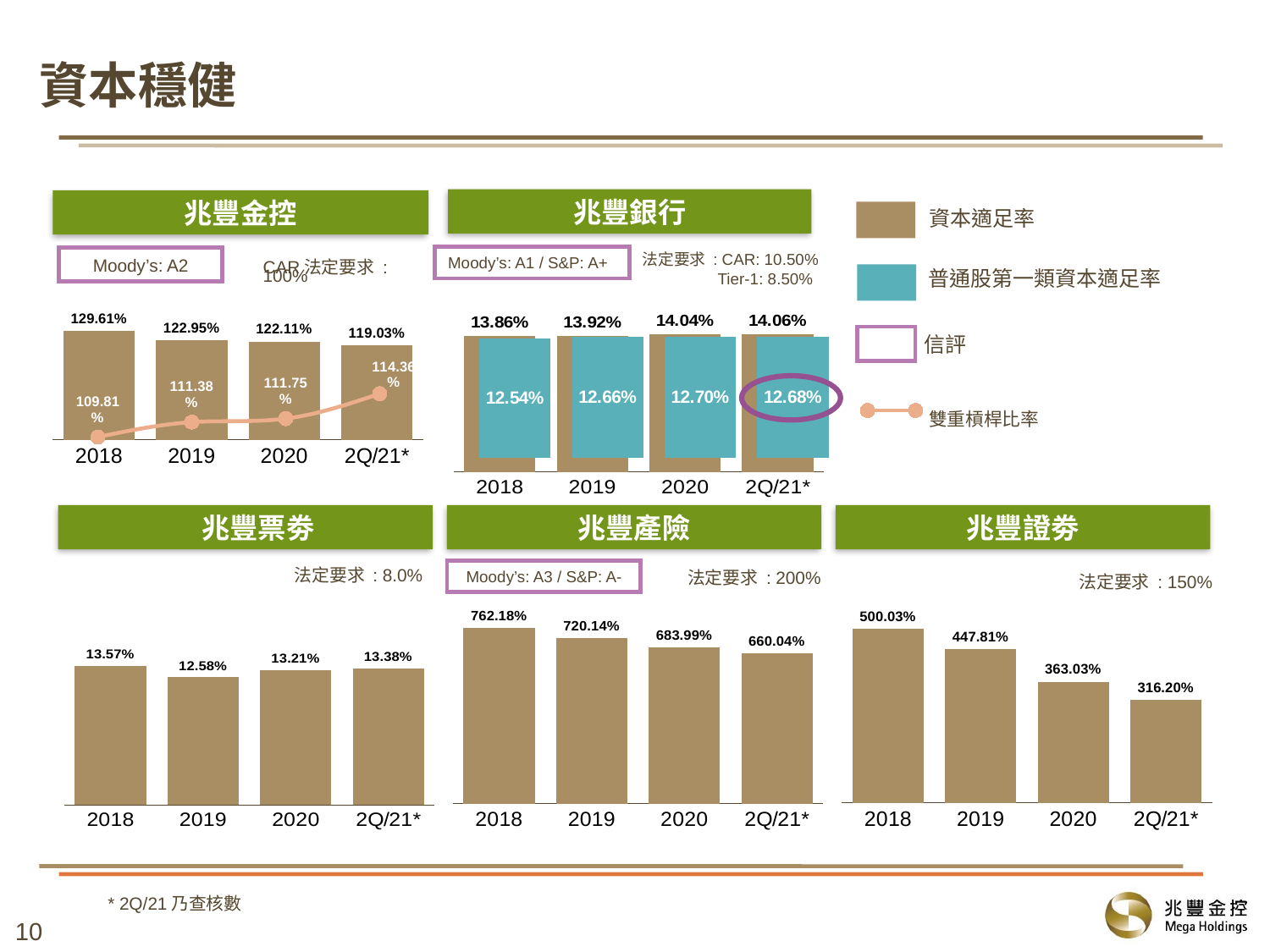
In the 兆豐金控 chart, what is the capital adequacy ratio (資本適足率) for 2018? 129.61% In the 兆豐金控 chart, does the capital adequacy ratio rise or fall from 2018 to 2Q/21*? fall In the 兆豐銀行 chart, what is the 普通股第一類資本適足率 for 2020? 12.70% In the 兆豐產險 chart, what is the difference between the 2018 and 2Q/21* values? 102.14% In the 兆豐票券 chart, which year has the lowest value? 2019 In the 兆豐票券 chart, what is the value for 2020? 13.21% In the 兆豐銀行 chart, what is the difference between the 資本適足率 and the 普通股第一類資本適足率 for 2018? 1.32% What kind of chart is the 兆豐產險 chart? bar chart In the 兆豐金控 chart, what is the 雙重槓桿比率 value for 2Q/21*? 114.36% In the 兆豐銀行 chart, which year has the highest 資本適足率? 2Q/21* In the 兆豐證券 chart, which is larger, the value for 2019 or the value for 2020? 2019 How many categories are shown on the x axis of the 兆豐證券 chart? 4